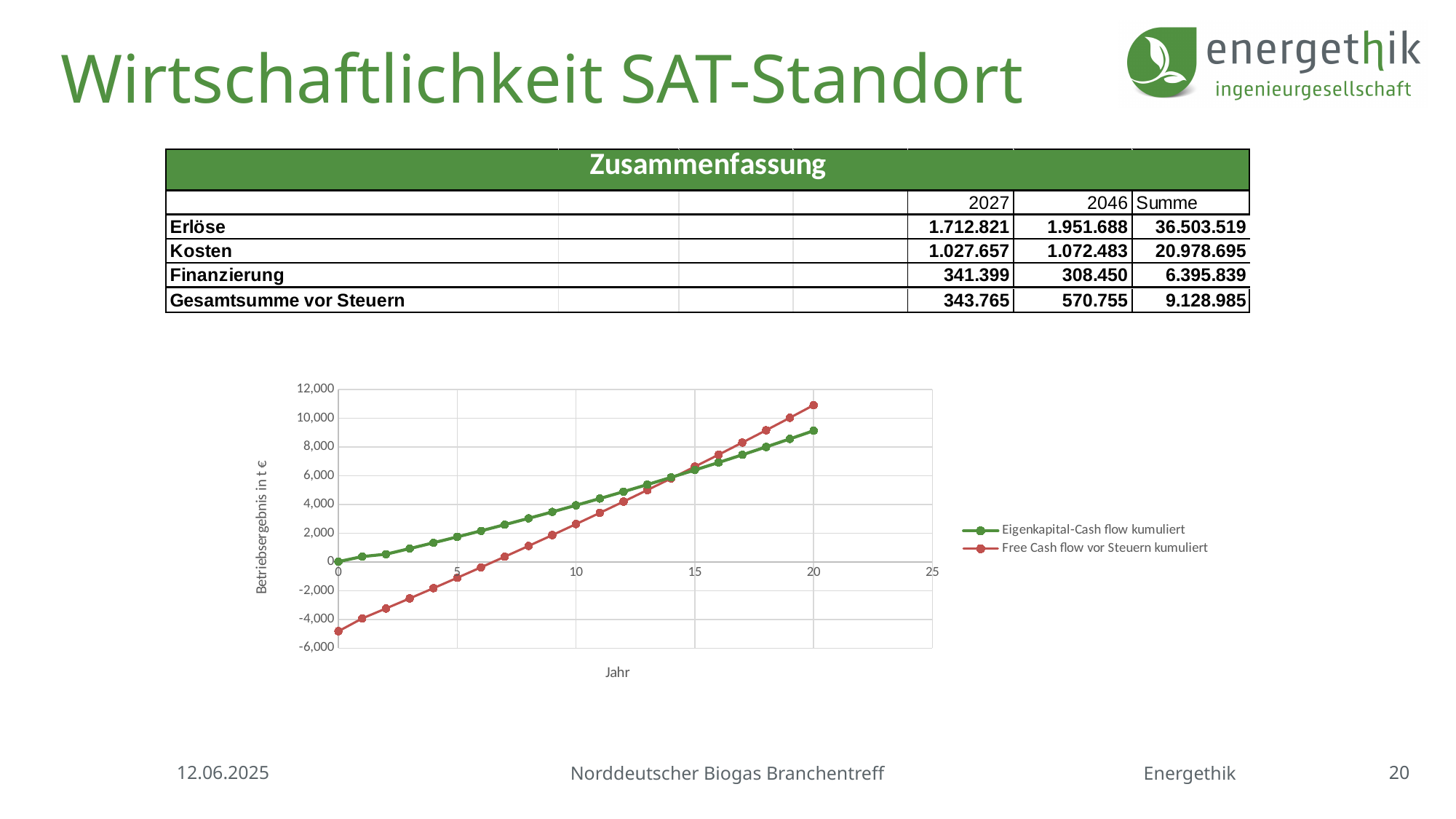
At year 20, which series has the higher value: Eigenkapital-Cash flow kumuliert or Free Cash flow vor Steuern kumuliert? Free Cash flow vor Steuern kumuliert At year 5, which series has the higher value: Eigenkapital-Cash flow kumuliert or Free Cash flow vor Steuern kumuliert? Eigenkapital-Cash flow kumuliert How many series does the chart legend list? 2 Do the values of the Free Cash flow vor Steuern kumuliert series rise or fall along the x axis? rise Is the value of Eigenkapital-Cash flow kumuliert at year 20 greater or less than 8,000? greater What are the two series named in the chart legend? Eigenkapital-Cash flow kumuliert and Free Cash flow vor Steuern kumuliert Is the value of Free Cash flow vor Steuern kumuliert at year 20 greater or less than 10,000? greater Is the value of Free Cash flow vor Steuern kumuliert at year 0 greater or less than -4,000? less Do the values of the Eigenkapital-Cash flow kumuliert series rise or fall along the x axis? rise What kind of chart is shown on the slide? line chart What is the label of the chart's y axis? Betriebsergebnis in t €